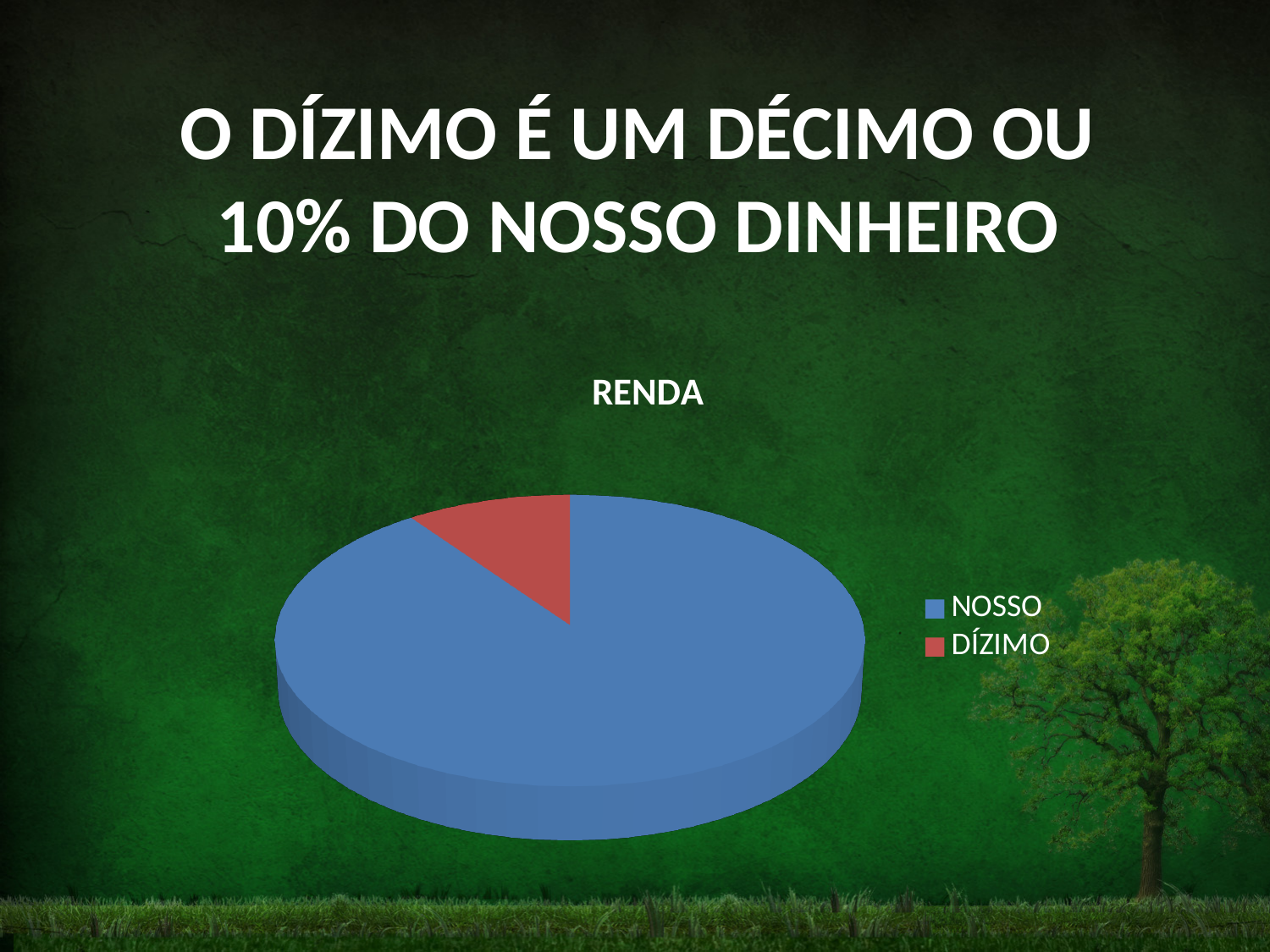
What is the title of the chart? RENDA How many slices does the pie chart have? 2 What colour is the DÍZIMO slice in the pie chart? red Which slice of the pie chart is the smallest? DÍZIMO Which slice of the pie chart is the largest? NOSSO Which slice is larger, NOSSO or DÍZIMO? NOSSO What kind of chart is shown on the slide? pie chart Which legend entry is shown in blue? NOSSO How many entries does the chart legend list? 2